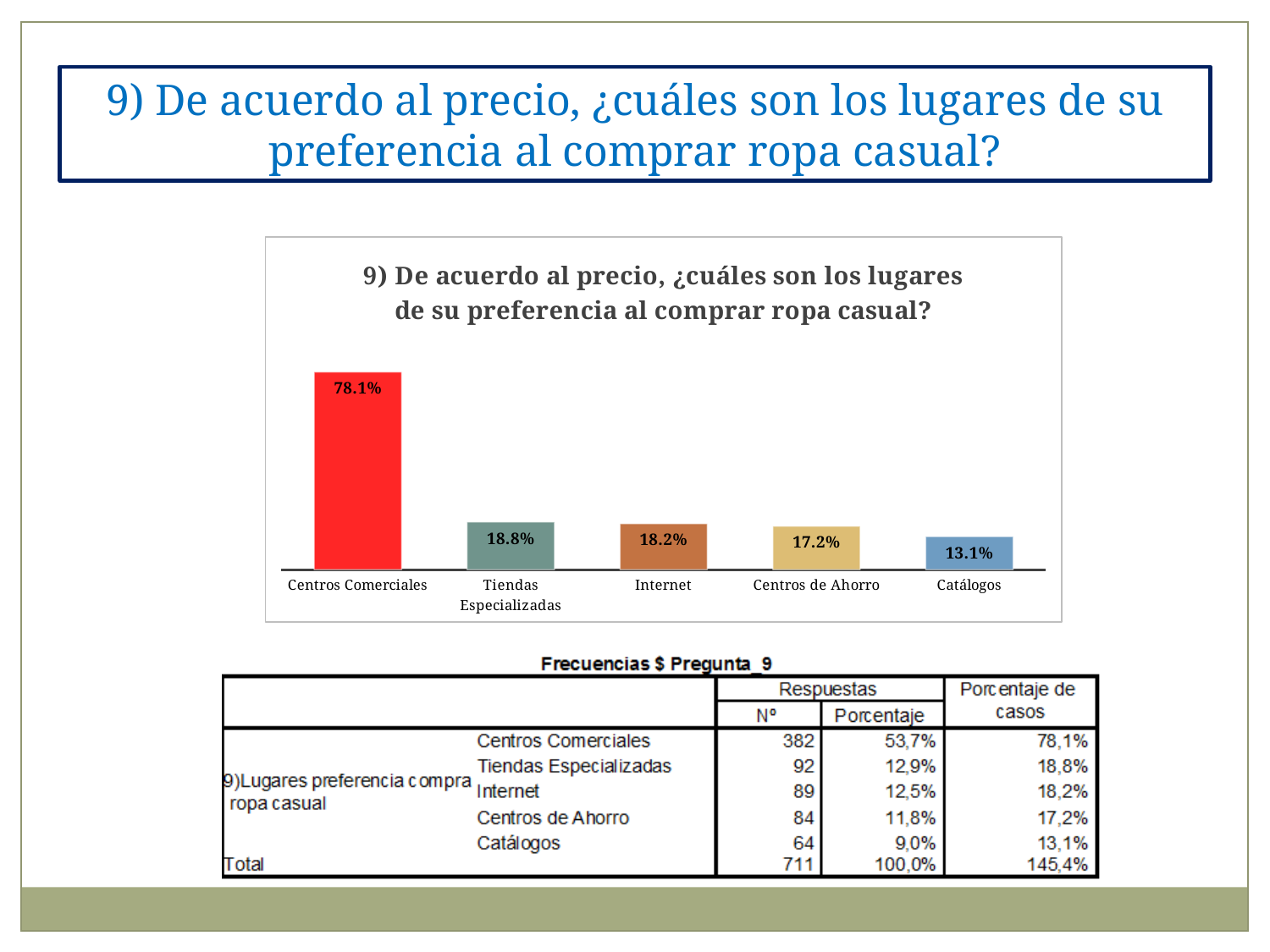
Which is larger, the value for Centros de Ahorro or the value for Catálogos? Centros de Ahorro What is the value shown for Tiendas Especializadas? 18.8% What kind of chart is shown on the slide? Bar chart What is the value shown for Centros Comerciales? 78.1% What is the difference between the values for Centros Comerciales and Catálogos? 65.0% What is the value shown for Catálogos? 13.1% How many categories are shown in the chart? 5 Which category has the highest value? Centros Comerciales What is the value shown for Internet? 18.2% What is the difference between the values for Tiendas Especializadas and Centros de Ahorro? 1.6% Which category has the lowest value? Catálogos What colour is the bar for Centros Comerciales? Red